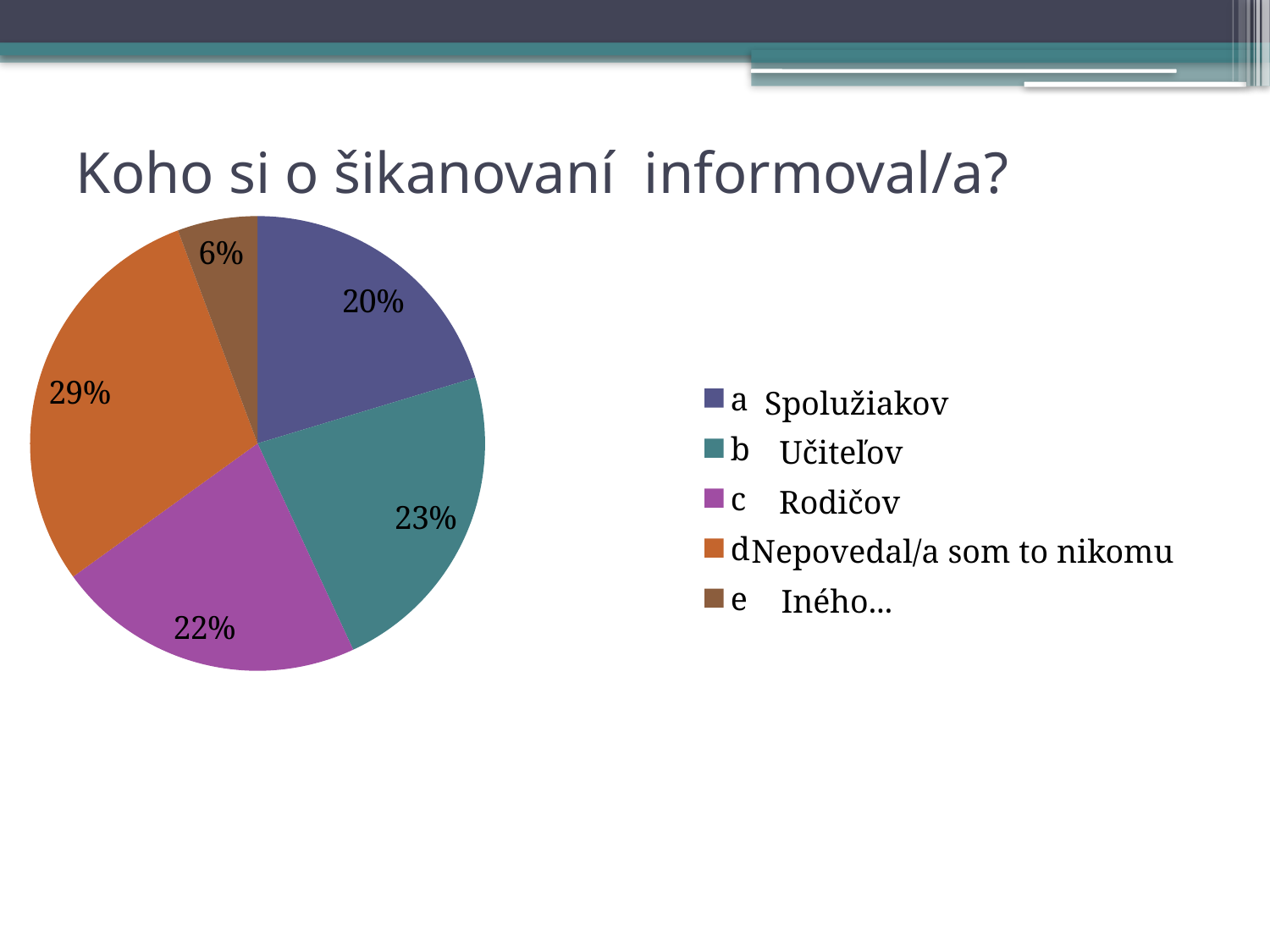
How many slices does the pie chart have? 5 Which category has the largest share of the pie? Nepovedal/a som to nikomu Which is larger, the share for 'Učiteľov' or the share for 'Iného...'? Učiteľov What percentage is shown for 'Iného...'? 6% Which category has the smallest share of the pie? Iného... What percentage is shown for 'Spolužiakov'? 20% What is the title of the chart on the slide? Koho si o šikanovaní informoval/a? What percentage is shown for 'Rodičov'? 22% What type of chart is shown on the slide? pie chart What is the difference in percentage points between 'Nepovedal/a som to nikomu' and 'Spolužiakov'? 9 What percentage is shown for 'Učiteľov'? 23% What percentage is shown for 'Nepovedal/a som to nikomu'? 29%